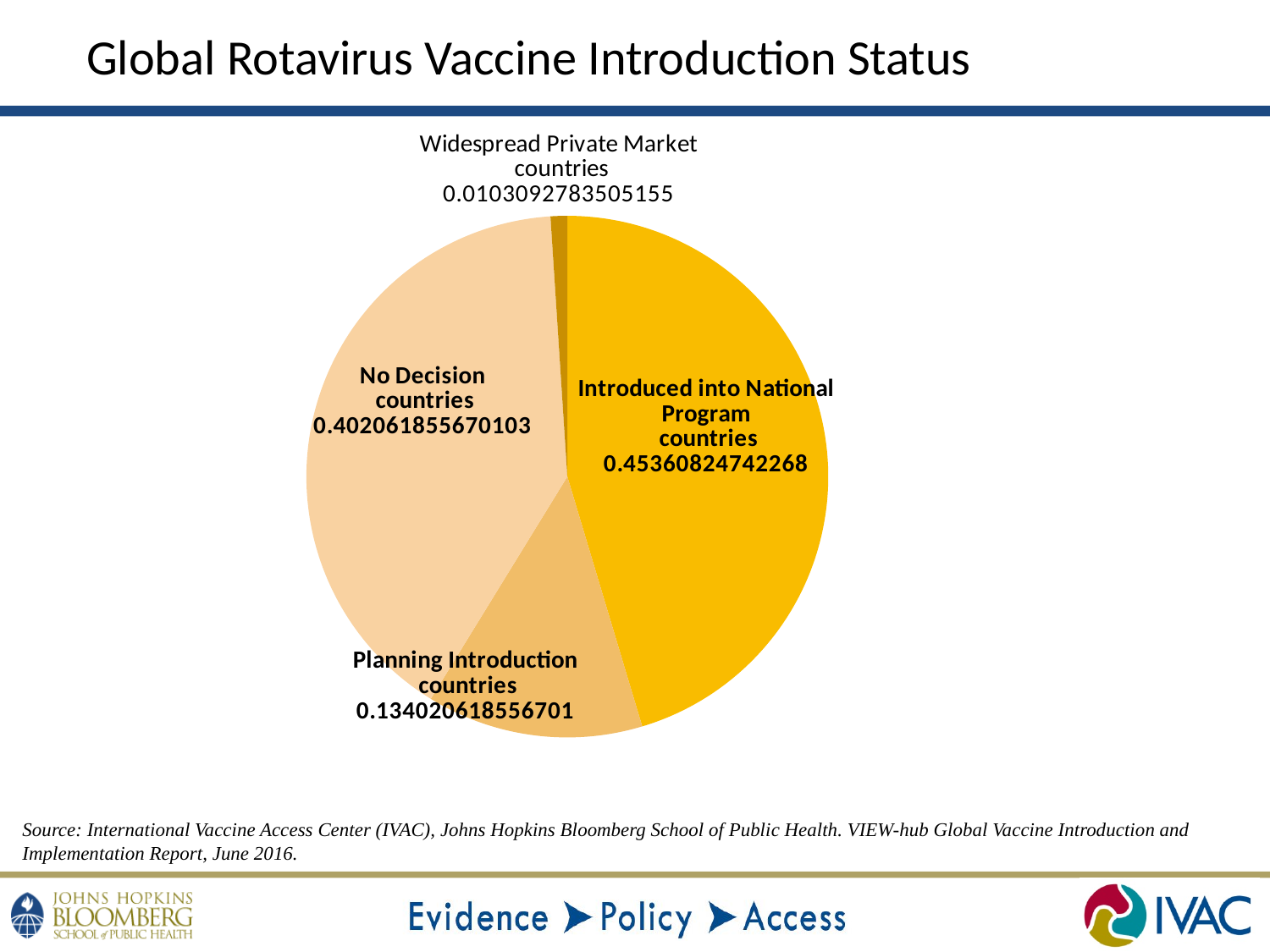
What is the value shown for Widespread Private Market countries? 0.0103092783505155 What is the value shown for No Decision countries? 0.402061855670103 What is the title of the chart on the slide? Global Rotavirus Vaccine Introduction Status What is the difference between the value for Introduced into National Program countries and the value for No Decision countries? 0.051546391752577 How many slices does the pie chart have? 4 What is the value shown for Planning Introduction countries? 0.134020618556701 Which is larger, the value for No Decision countries or the value for Planning Introduction countries? No Decision countries Which category has the smallest slice of the pie? Widespread Private Market countries Which category has the largest slice of the pie? Introduced into National Program countries What kind of chart is shown on the slide? pie chart According to the source note, from which month and year is the VIEW-hub report the chart is based on? June 2016 What is the value shown for Introduced into National Program countries? 0.45360824742268